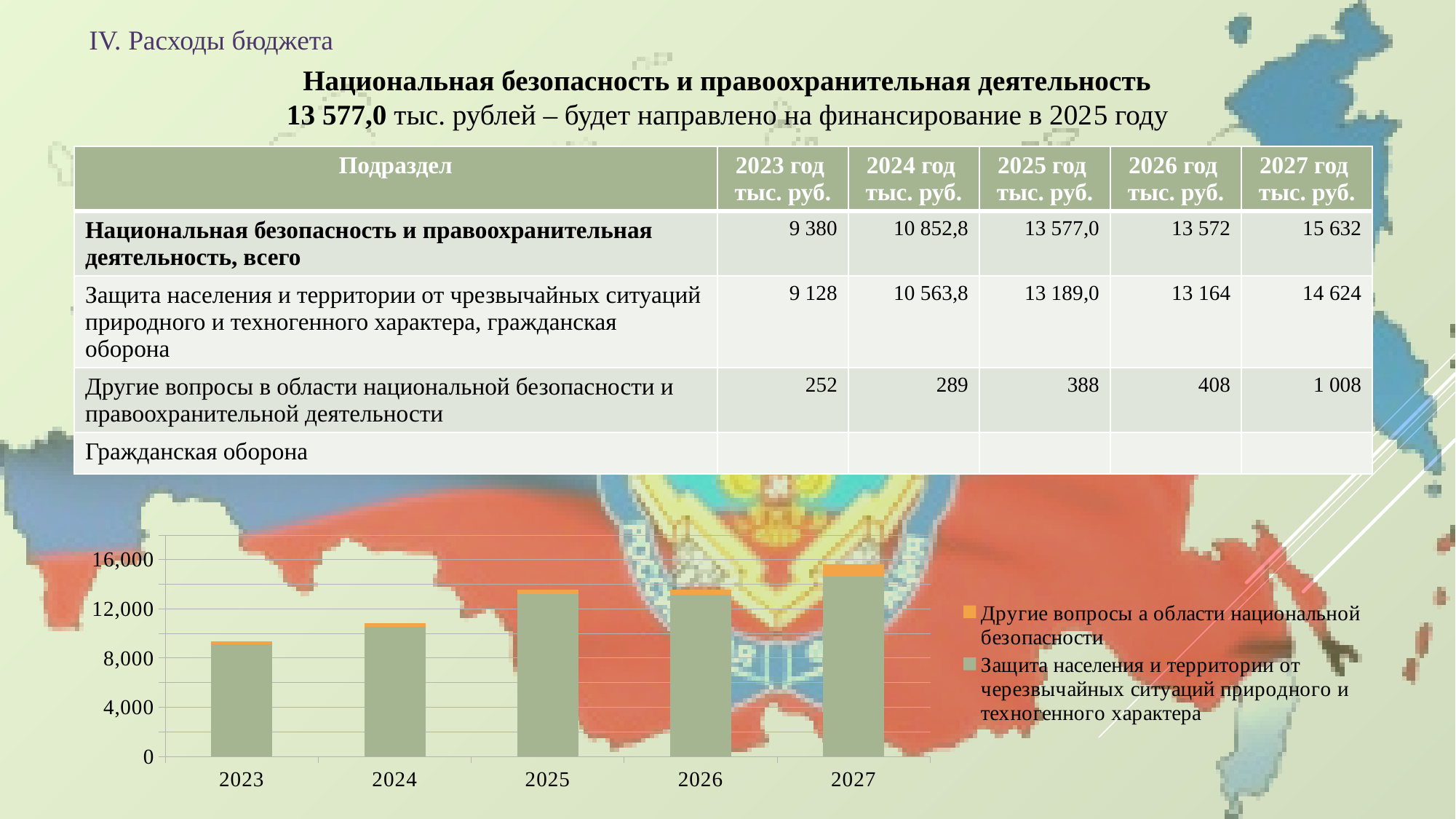
Is the total bar for 2027 greater or less than 16,000? less Is the total bar for 2024 greater or less than 12,000? less What kind of chart is shown at the bottom of the slide? Stacked bar chart How many years are shown on the x axis of the bar chart? 5 Is the total bar for 2025 greater or less than 12,000? greater Which colour represents the series 'Другие вопросы а области национальной безопасности' in the legend? Orange Which year has the shortest bar in the chart? 2023 Which bar is taller, 2024 or 2025? 2025 Do the bar heights overall rise or fall from 2023 to 2027? rise Which year has the tallest bar in the chart? 2027 How many series does the legend of the bar chart list? 2